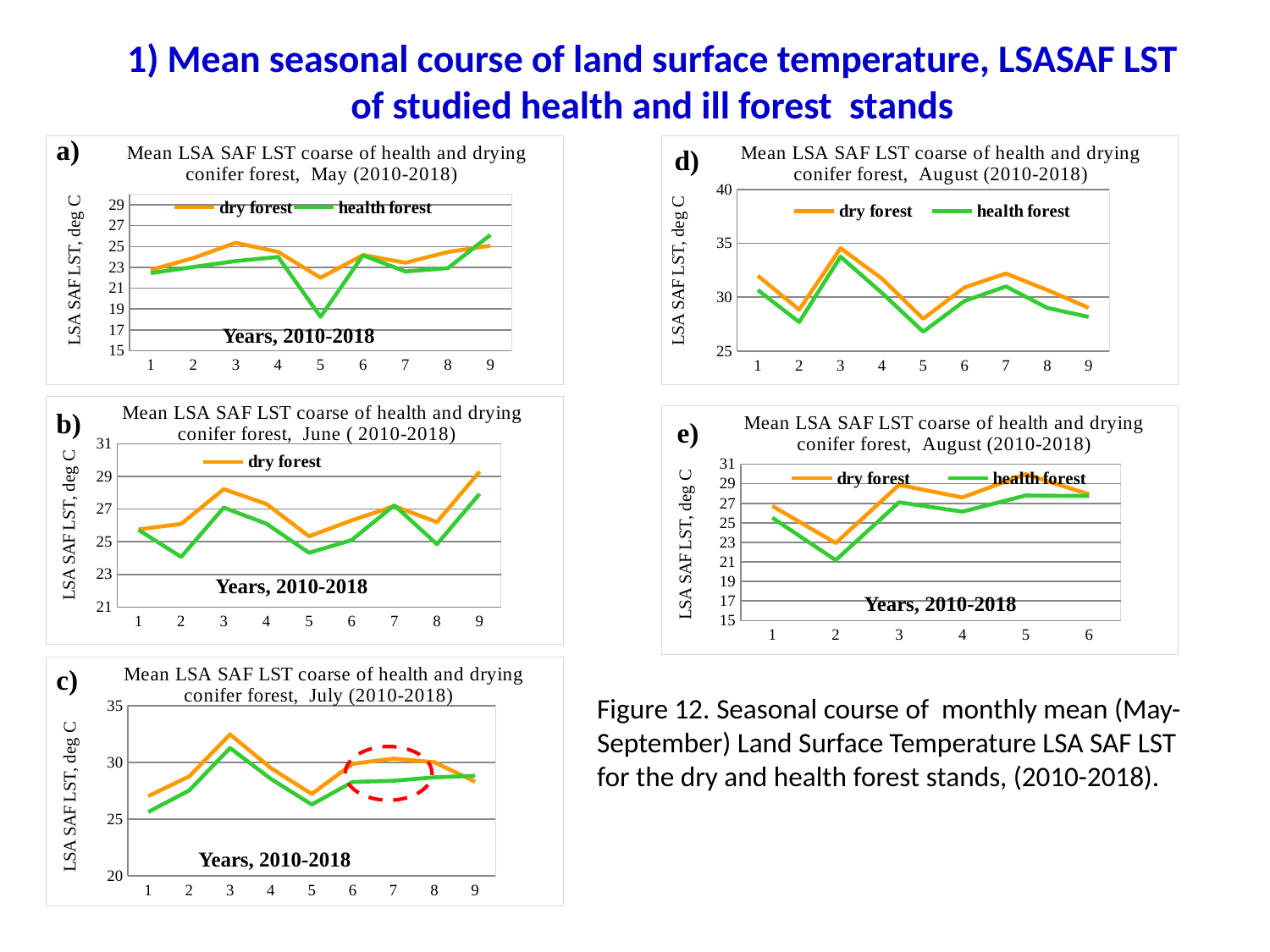
In chart c) (July), is the value for dry forest at point 3 greater or less than 30? greater In chart e) (bottom right), how many points are plotted along the x axis for each series? 6 In chart e) (bottom right), is the value for health forest at point 2 greater or less than 23? less In chart b) (June), is the value for dry forest at point 9 greater or less than 27? greater In chart a) (May), how many series does the legend list? 2 What kind of chart is chart a) (May)? line chart In chart c) (July), at which point on the x axis does dry forest reach its highest value? 3 In chart d) (August, top right), at point 1, which series has the higher value, dry forest or health forest? dry forest In chart a) (May), how many points are plotted along the x axis for each series? 9